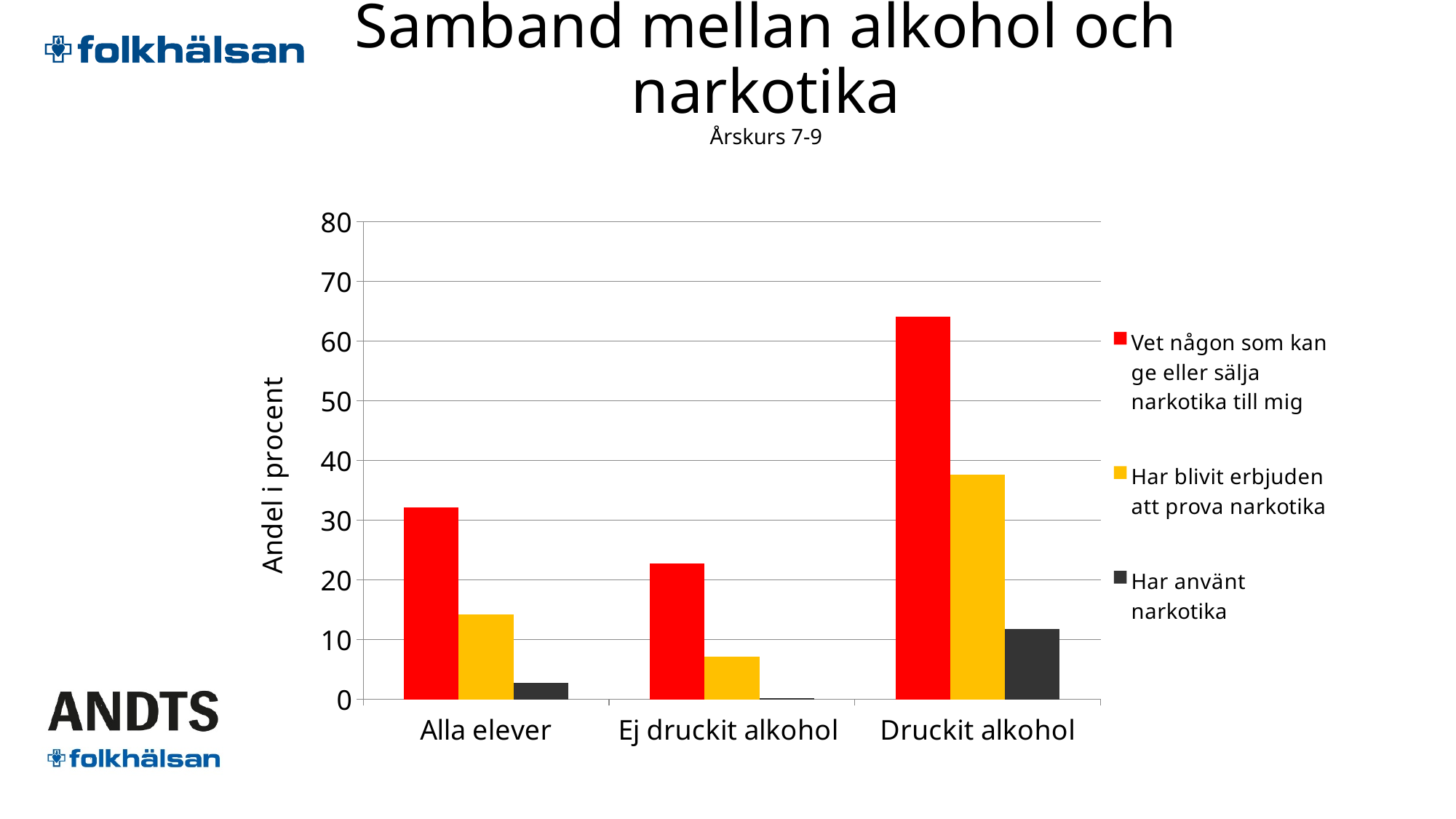
What kind of chart is shown on the slide? bar chart Is the value for 'Vet någon som kan ge eller sälja narkotika till mig' in the 'Ej druckit alkohol' category greater or less than 30? less Which category has the highest value for 'Vet någon som kan ge eller sälja narkotika till mig'? Druckit alkohol Which category has the lowest value for 'Har använt narkotika'? Ej druckit alkohol Is the value for 'Har använt narkotika' in the 'Druckit alkohol' category greater or less than 10? greater What is the label of the y axis? Andel i procent How many categories are shown on the x axis? 3 Which category has the lowest value for 'Har blivit erbjuden att prova narkotika'? Ej druckit alkohol How many series does the legend list? 3 Which is larger: 'Har blivit erbjuden att prova narkotika' for 'Druckit alkohol' or 'Vet någon som kan ge eller sälja narkotika till mig' for 'Alla elever'? Har blivit erbjuden att prova narkotika for Druckit alkohol Is the value for 'Har blivit erbjuden att prova narkotika' in the 'Alla elever' category greater or less than 20? less